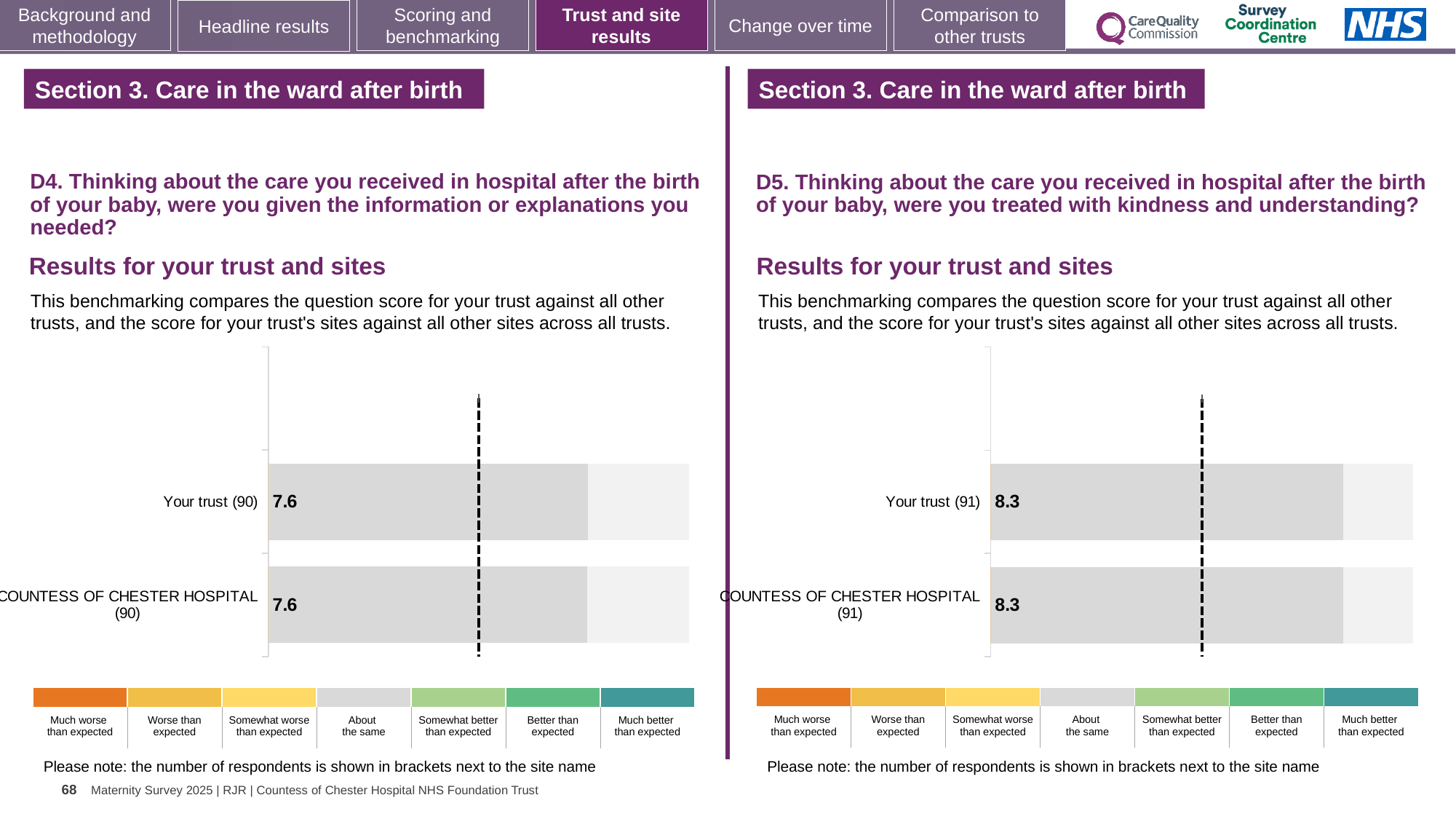
What kind of chart is the left chart (D4)? Bar chart On the right chart (D5), what is the score for Your trust? 8.3 On the right chart (D5), what is the score for COUNTESS OF CHESTER HOSPITAL? 8.3 How many bars are plotted on the right chart (D5)? 2 On the right chart (D5), how many respondents are shown in brackets next to COUNTESS OF CHESTER HOSPITAL? 91 On the left chart (D4), what is the difference between the score for Your trust and the score for COUNTESS OF CHESTER HOSPITAL? 0 On the left chart (D4), what is the score for Your trust? 7.6 Is the score for Your trust on the right chart (D5) larger or smaller than the score for Your trust on the left chart (D4)? Larger On the right chart (D5), what is the difference between the score for Your trust and the score for COUNTESS OF CHESTER HOSPITAL? 0 On the left chart (D4), how many respondents are shown in brackets next to Your trust? 90 On the left chart (D4), what is the score for COUNTESS OF CHESTER HOSPITAL? 7.6 How many bars are plotted on the left chart (D4)? 2